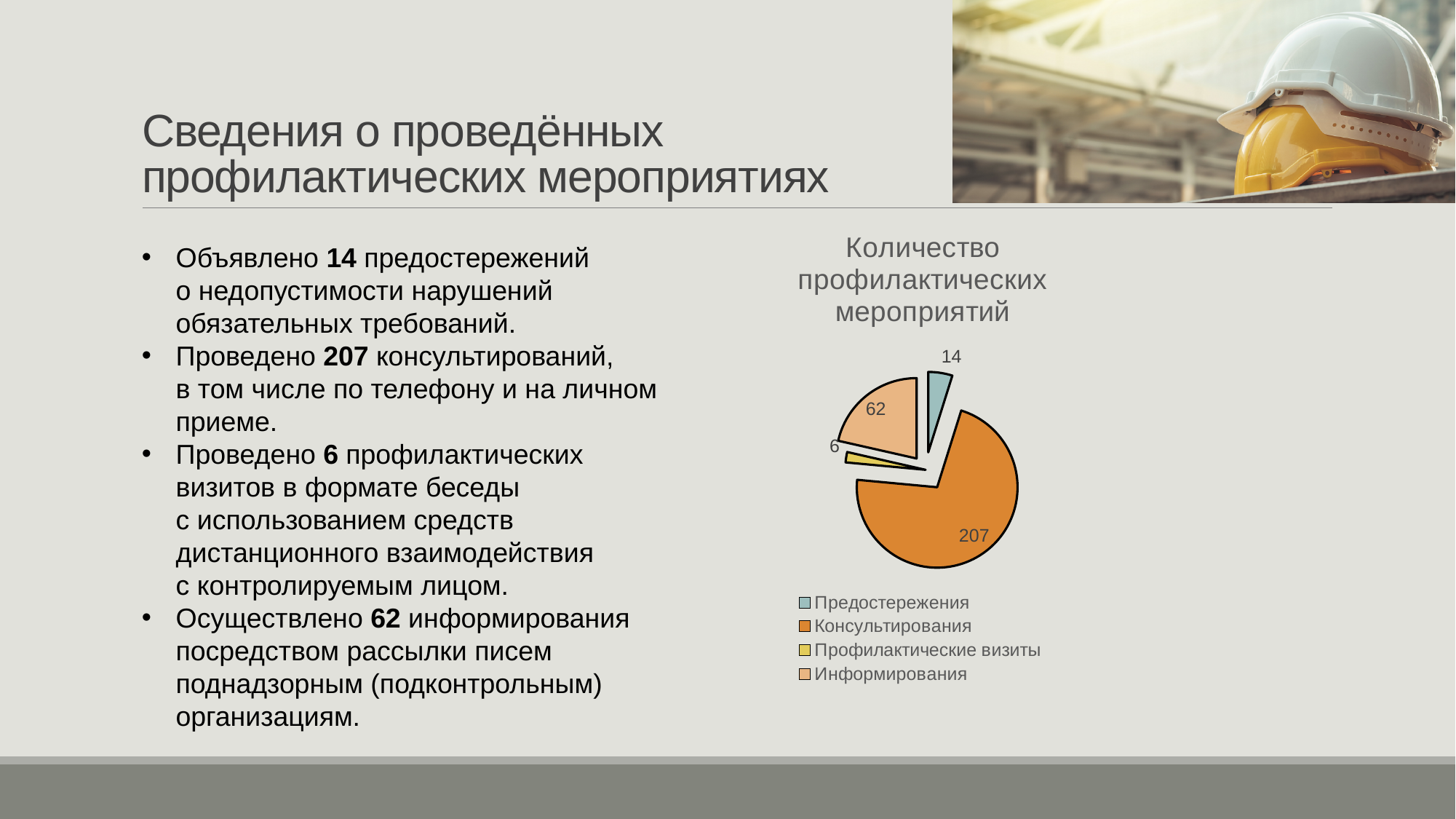
How many categories does the pie chart show? 4 What is the total of all slices in the pie chart? 289 Which category has the smallest slice in the pie chart? Профилактические визиты What is the value for Профилактические визиты in the pie chart? 6 What is the value for Консультирования in the pie chart? 207 What is the title of the chart? Количество профилактических мероприятий What kind of chart is shown on the slide? pie chart What is the value for Предостережения in the pie chart? 14 What is the value for Информирования in the pie chart? 62 Which is larger, the value for Предостережения or the value for Профилактические визиты? Предостережения Which category has the largest slice in the pie chart? Консультирования What is the difference between the values for Консультирования and Информирования? 145